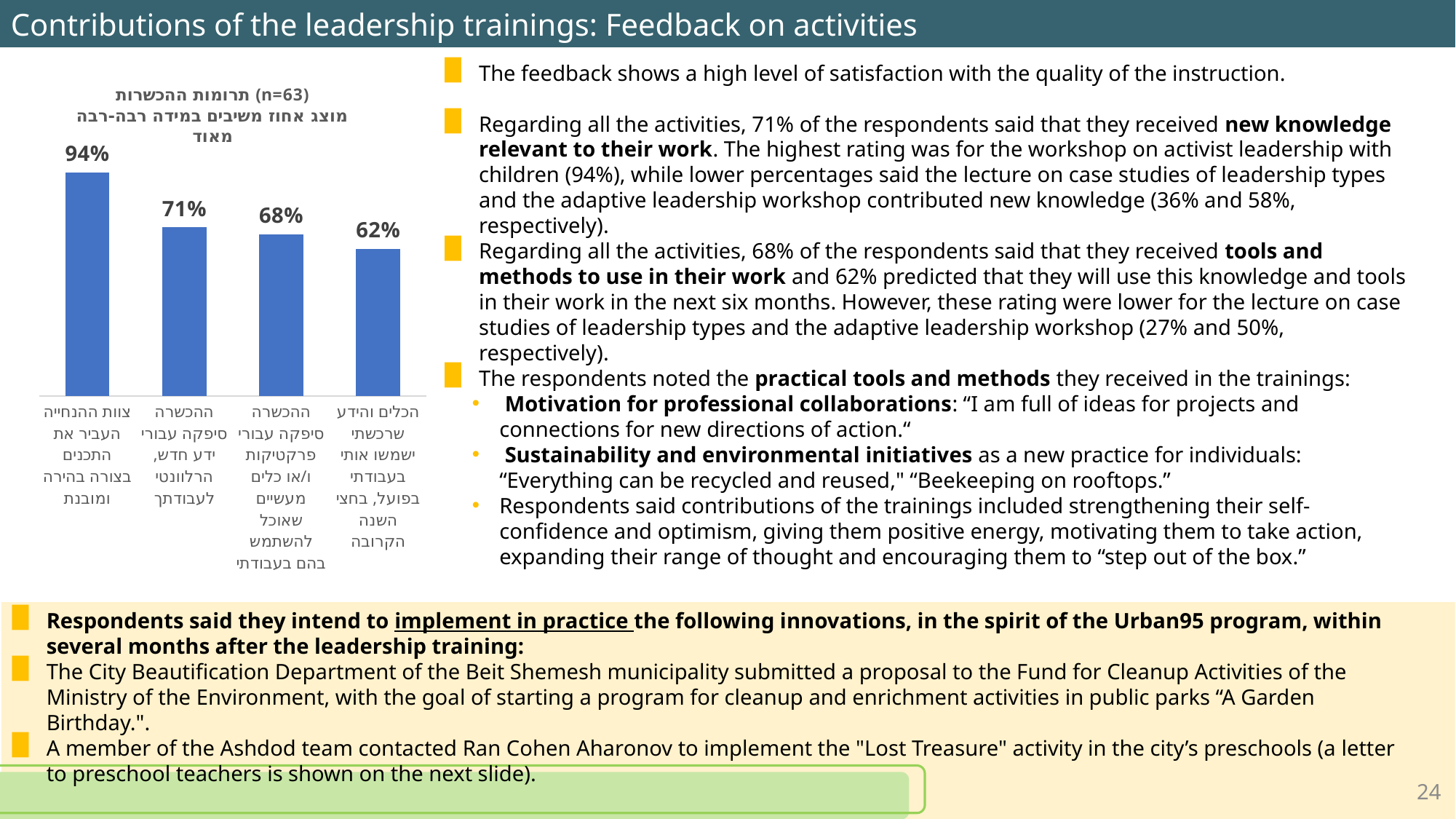
Which is larger: the value for the second bar from the left or the third bar from the left? the second bar (71%) What is the value of the bar labelled 'ההכשרה סיפקה עבורי ידע חדש, הרלוונטי לעבודתך'? 71% How many bars does the chart show? 4 What sample size (n) is stated in the chart title? n=63 What is the difference between the highest bar (94%) and the lowest bar (62%)? 32% Which bar has the highest value? צוות ההנחייה העביר את התכנים בצורה בהירה ומובנת (leftmost bar) Do the bar values rise or fall from left to right? fall What is the value of the leftmost bar (צוות ההנחייה העביר את התכנים בצורה בהירה ומובנת)? 94% Which bar has the lowest value? הכלים והידע שרכשתי ישמשו אותי בעבודתי בפועל, בחצי השנה הקרובה (rightmost bar) What is the value of the rightmost bar (הכלים והידע שרכשתי ישמשו אותי בעבודתי בפועל)? 62% What type of chart is shown on the slide? bar chart What is the value of the third bar from the left (ההכשרה סיפקה עבורי פרקטיקות ו/או כלים מעשיים)? 68%